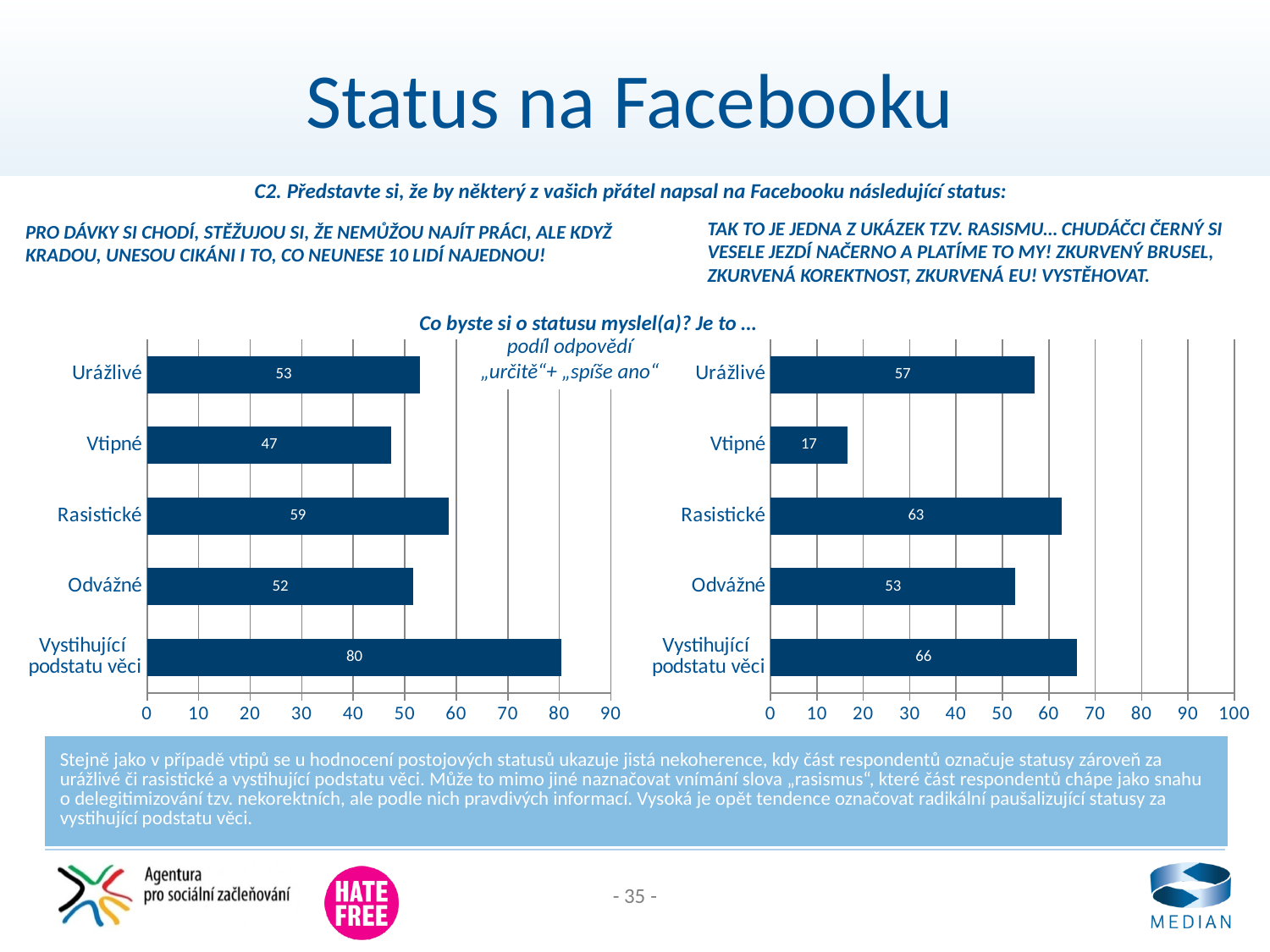
What type of chart is the right chart? Bar chart In the right chart, which category has the highest value? Vystihující podstatu věci In the left chart, what is the value for Vystihující podstatu věci? 80 Which is larger: the value for Vtipné in the left chart or in the right chart? Left chart (47) In the left chart, which category has the lowest value? Vtipné In the left chart, what is the value for Rasistické? 59 In the left chart, what is the difference between Vystihující podstatu věci and Vtipné? 33 In the right chart, which category has the lowest value? Vtipné In the right chart, what is the value for Odvážné? 53 In the right chart, what is the difference between Rasistické and Urážlivé? 6 How many categories does the left chart show? 5 In the right chart, what is the value for Vtipné? 17